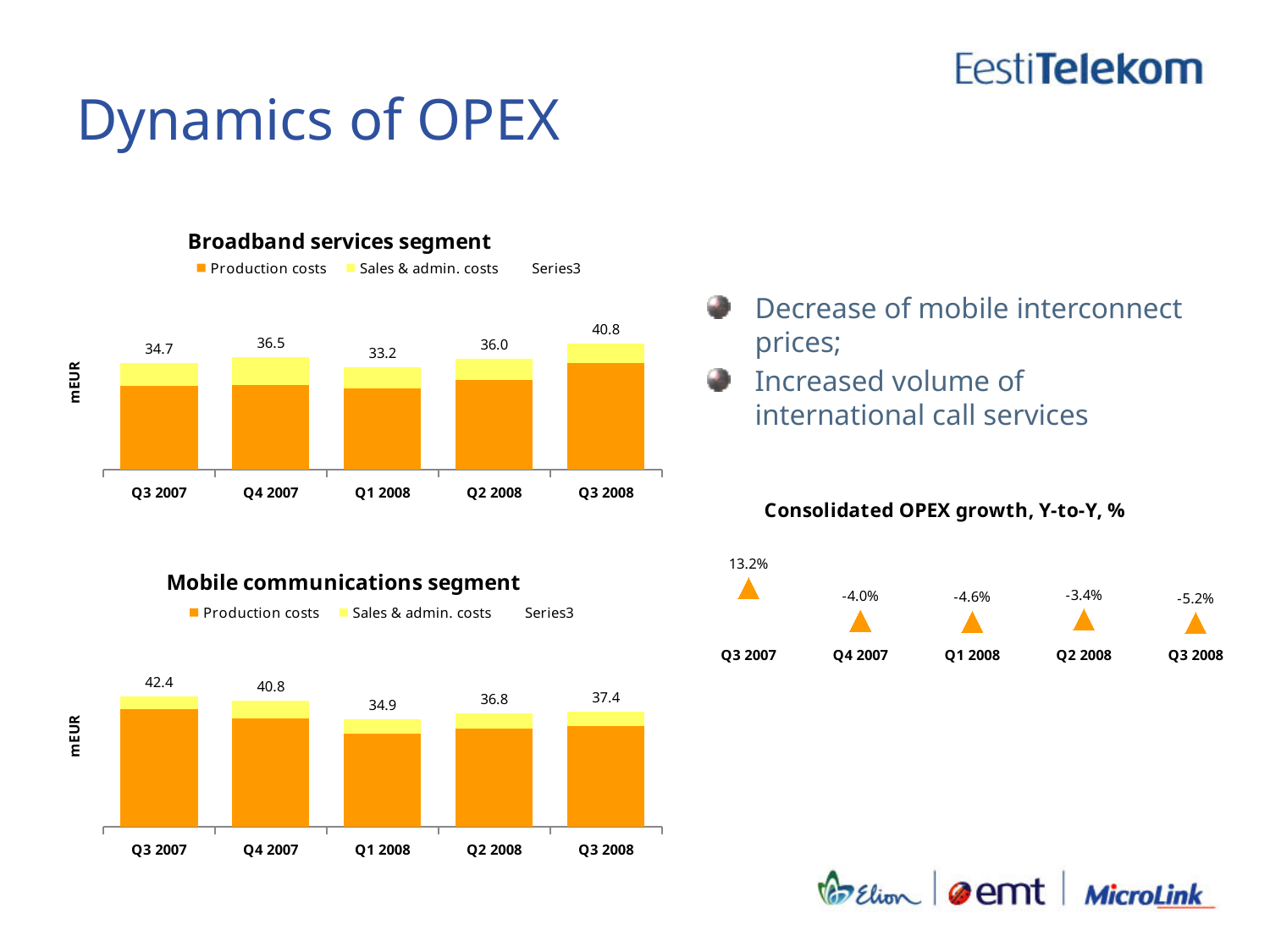
How many quarters are shown on the x axis of the Mobile communications segment chart? 5 In the Mobile communications segment chart, what is the difference between the labelled totals for Q3 2007 and Q1 2008? 7.5 What kind of chart is the Broadband services segment chart? Stacked bar chart In the Mobile communications segment chart, what is the total labelled for Q3 2007? 42.4 In the Mobile communications segment chart, which quarter has the highest labelled total? Q3 2007 In the Broadband services segment chart, what is the total OPEX value labelled for Q3 2008? 40.8 In the Consolidated OPEX growth, Y-to-Y, % chart, which quarter has the highest value? Q3 2007 In the Mobile communications segment chart, which is larger, the total for Q2 2008 or Q3 2008? Q3 2008 In the Broadband services segment chart, which quarter has the lowest labelled total? Q1 2008 In the Consolidated OPEX growth, Y-to-Y, % chart, what is the value for Q3 2008? -5.2% In the Broadband services segment chart, what is the difference between the labelled totals for Q3 2008 and Q3 2007? 6.1 How many series does the legend of the Broadband services segment chart list? 3